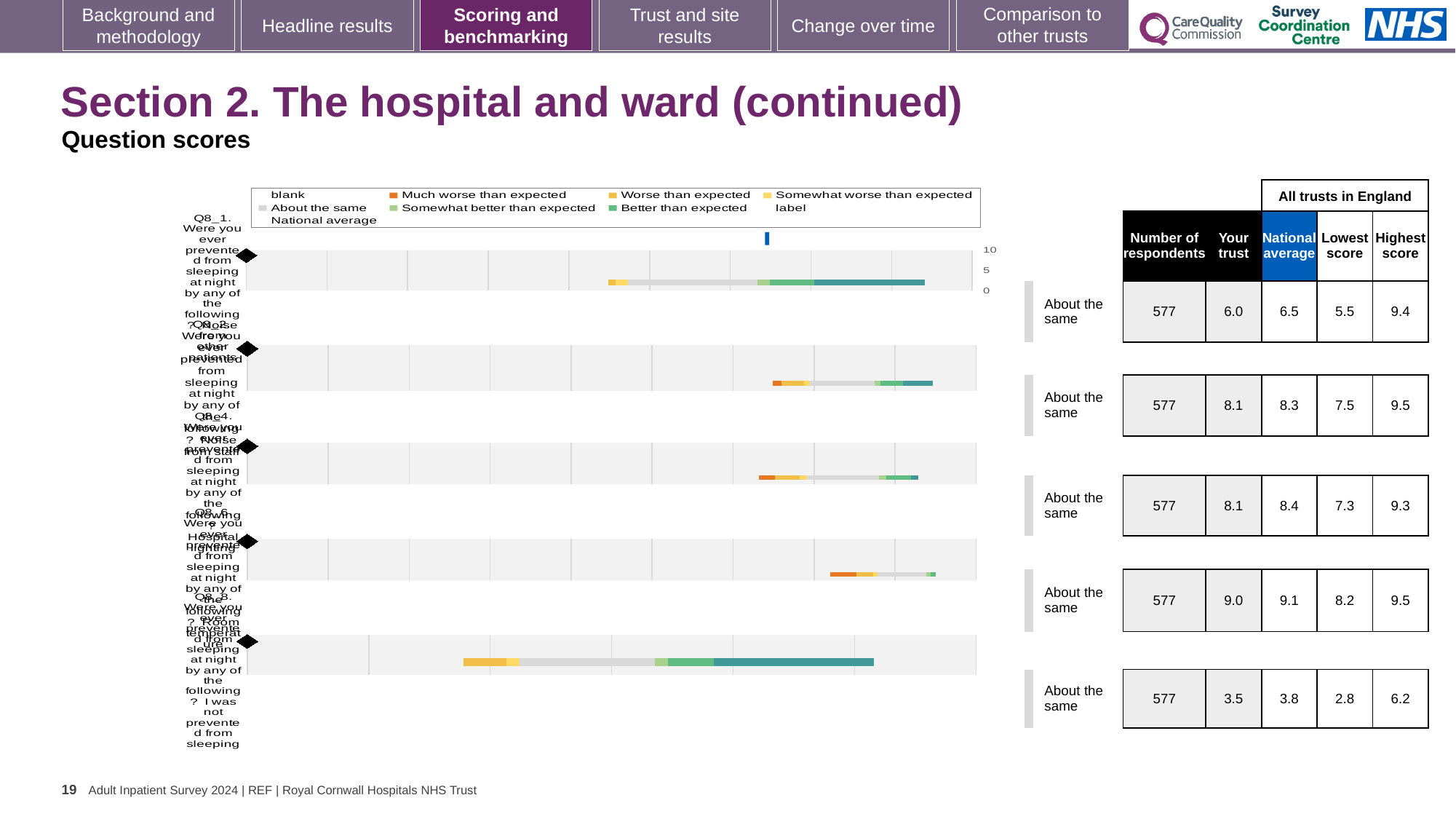
Which row has the highest 'Your trust' score? Q8_6 (fourth row), 9.0 What benchmark category is shown for the bottom row (Q8_8)? About the same How many question rows (bars) does the chart show? 5 What kind of chart is shown on the slide? bar chart For the top row (Q8_1), which is larger: the 'Your trust' score or the national average? National average What is the highest score among all trusts in England for the fourth row (Q8_6)? 9.5 What is the 'Your trust' score for the top row (Q8_1)? 6.0 Which row has the lowest 'Your trust' score? Q8_8 (bottom row), 3.5 What is the national average for the bottom row (Q8_8)? 3.8 What is the difference between the national average and the 'Your trust' score for the third row (Q8_4)? 0.3 What is the lowest score among all trusts in England for the bottom row (Q8_8)? 2.8 What is the number of respondents for the second row (Q8_2)? 577